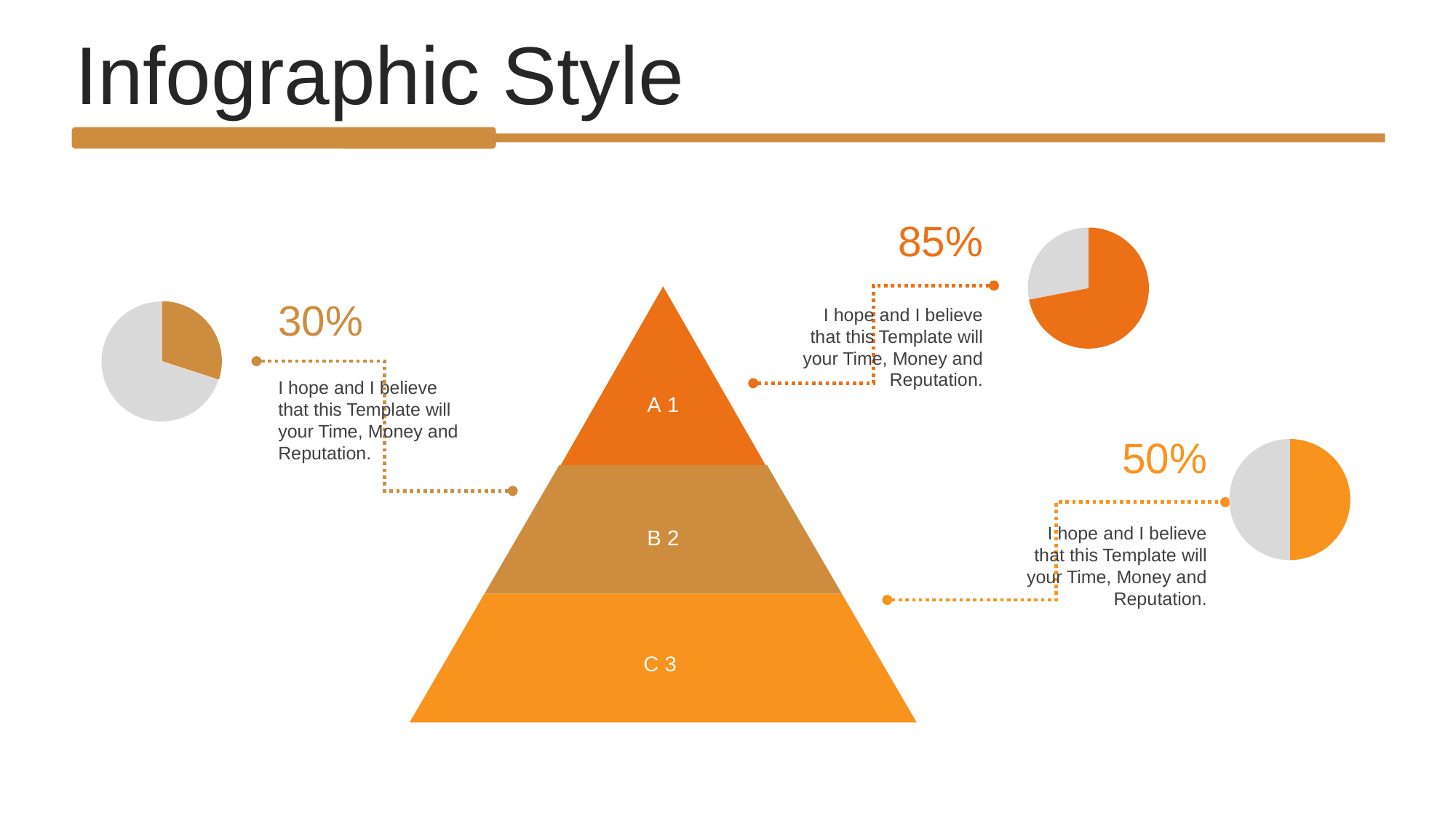
How many pie charts are on the slide? 3 What percentage is shown next to the pie chart in the bottom right of the slide? 50% Which shows a larger percentage, the left pie chart or the bottom-right pie chart? The bottom-right pie chart What percentage is shown next to the pie chart in the top right of the slide? 85% Which of the three pie charts shows the lowest percentage? The left pie chart (30%) Which of the three pie charts shows the highest percentage? The top-right pie chart (85%) What kind of chart is used to show the 30%, 85% and 50% values? Pie chart What percentage is shown next to the pie chart on the left of the slide? 30% How many levels does the pyramid in the centre of the slide have? 3 What is the difference between the percentage of the top-right pie chart and the bottom-right pie chart? 35% What share of the left pie chart is grey (not filled)? 70% What is the difference between the percentage of the top-right pie chart and the left pie chart? 55%